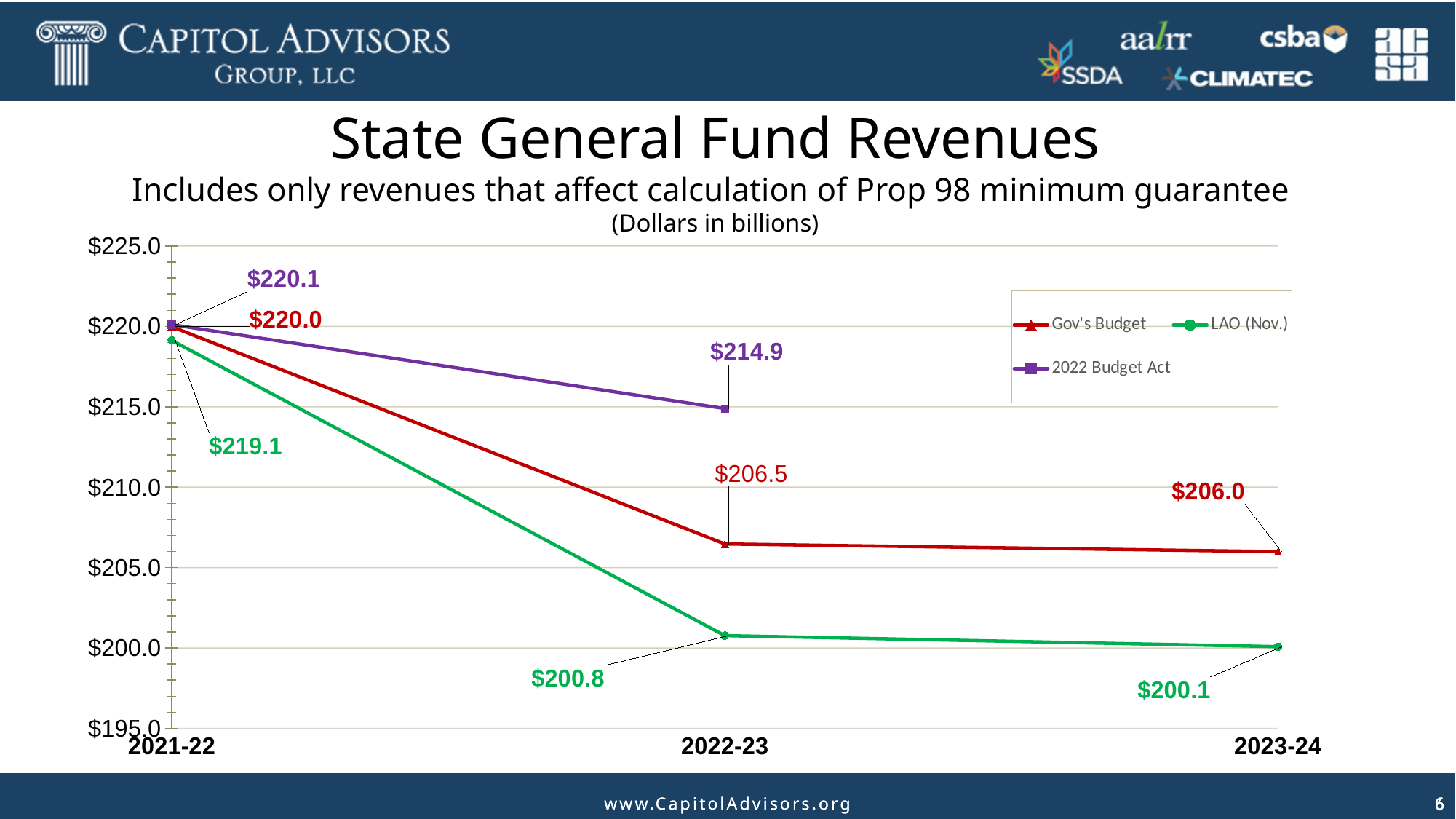
How many series does the legend list? 3 What is the LAO (Nov.) value for 2023-24? $200.1 What is the 2022 Budget Act value for 2022-23? $214.9 What is the LAO (Nov.) value for 2021-22? $219.1 Which is larger in 2022-23, the Gov's Budget value or the LAO (Nov.) value? Gov's Budget How many fiscal years are shown on the x axis? 3 What is the difference between the Gov's Budget and LAO (Nov.) values for 2023-24? $5.9 Which series has the lowest value in 2023-24? LAO (Nov.) Does the Gov's Budget series rise or fall from 2021-22 to 2023-24? Fall What is the Gov's Budget value for 2022-23? $206.5 Which series has the highest value in 2022-23? 2022 Budget Act What kind of chart is shown on the slide? Line chart